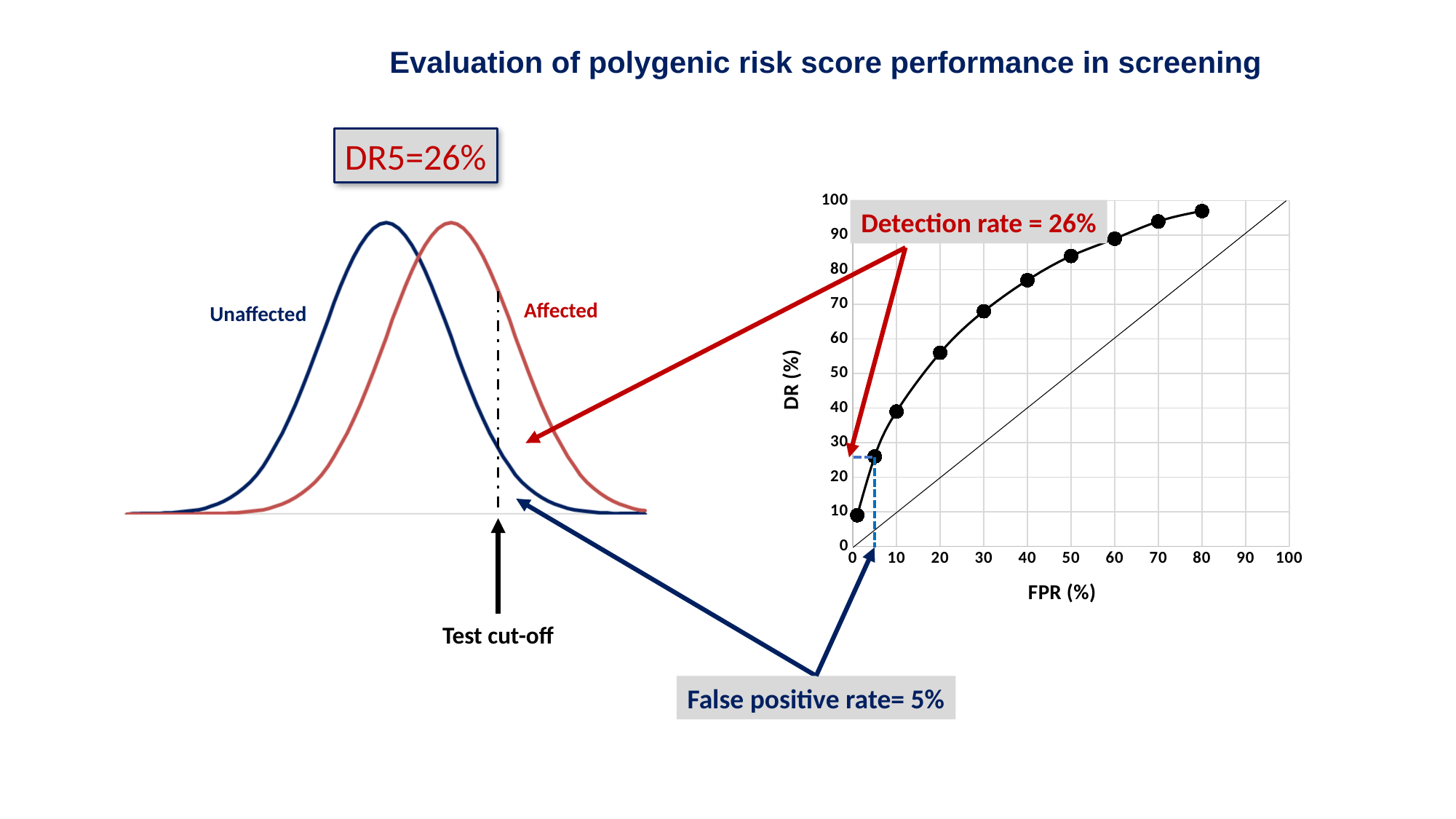
On the right-hand chart, what is the label of the x axis? FPR (%) On the right-hand chart, does the detection rate rise or fall as the false positive rate increases? rises On the right-hand chart, how many plotted data points are on the curve? 10 On the right-hand chart, is the DR value at FPR 20 greater or less than 50? greater On the right-hand chart, what is the detection rate at a false positive rate of 5%? 26% On the right-hand chart, which has the higher DR: the point at FPR 30 or the point at FPR 60? FPR 60 On the right-hand chart, what is the label of the y axis? DR (%) On the left-hand chart, how many distribution curves are plotted? 2 On the right-hand chart, is the DR value at FPR 50 greater or less than 80? greater On the right-hand chart, is the DR value at FPR 10 greater or less than 30? greater On the left-hand chart, which curve has its peak further to the right, Unaffected or Affected? Affected